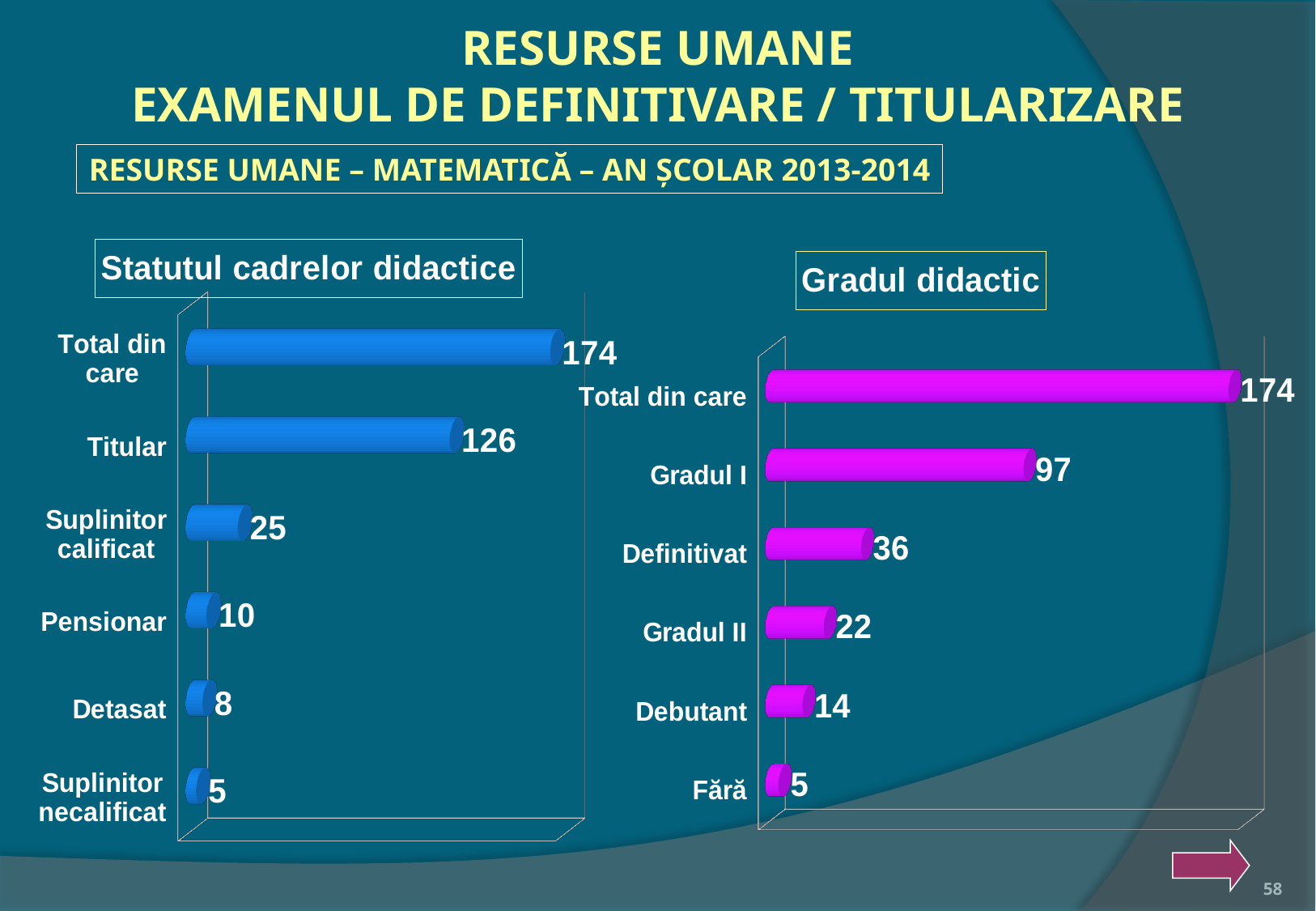
In the 'Gradul didactic' chart, what is the value for Debutant? 14 What colour are the bars in the 'Gradul didactic' chart? Magenta In the 'Statutul cadrelor didactice' chart, what is the difference between Titular and Suplinitor calificat? 101 In the 'Gradul didactic' chart, what is the difference between Definitivat and Gradul II? 14 In the 'Gradul didactic' chart, which category other than 'Total din care' has the highest value? Gradul I What kind of chart is the 'Statutul cadrelor didactice' chart? Bar chart How many categories are shown in the 'Gradul didactic' chart? 6 In the 'Statutul cadrelor didactice' chart, which category other than 'Total din care' has the lowest value? Suplinitor necalificat In the 'Statutul cadrelor didactice' chart, what is the value for Titular? 126 In the 'Statutul cadrelor didactice' chart, which is larger, Pensionar or Detasat? Pensionar In the 'Gradul didactic' chart, what is the value for Gradul I? 97 In the 'Statutul cadrelor didactice' chart, what is the value for Suplinitor calificat? 25